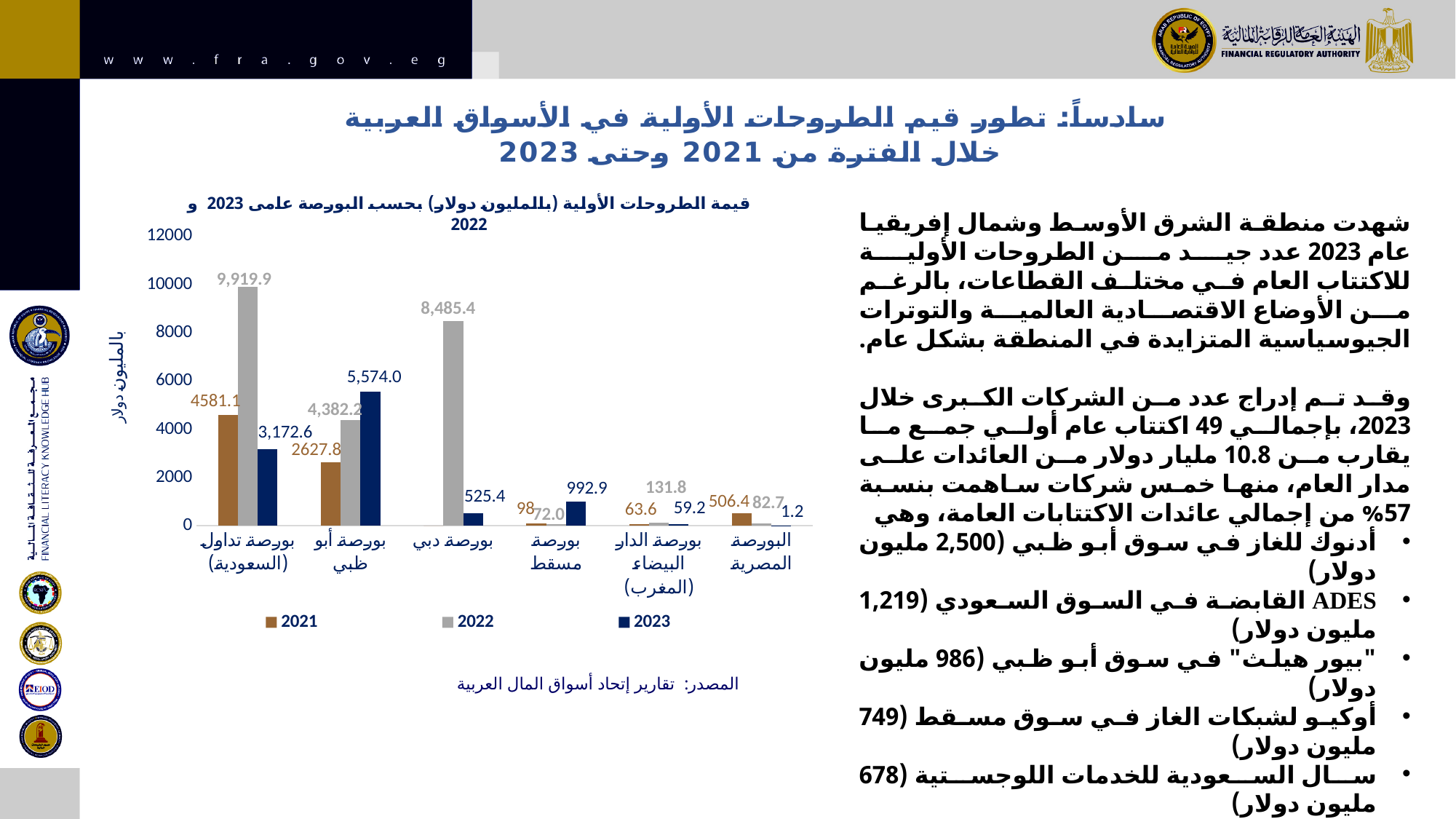
Which exchange has the highest 2022 value? بورصة تداول (السعودية) Which is larger for بورصة مسقط: the 2023 value or the 2022 value? 2023 What is the 2022 value for بورصة دبي? 8,485.4 What type of chart is shown on the slide? Bar chart What is the difference between the 2023 and 2022 values for بورصة أبو ظبي? 1,191.8 How many stock exchanges (categories) are shown on the x axis of the chart? 6 What is the 2022 value for بورصة تداول (السعودية)? 9,919.9 How many series does the chart legend list? 3 What is the 2023 value for البورصة المصرية? 1.2 Which exchange has the lowest 2023 value? البورصة المصرية What is the unit shown on the y axis of the chart? بالمليون دولار What is the 2023 value for بورصة أبو ظبي? 5,574.0